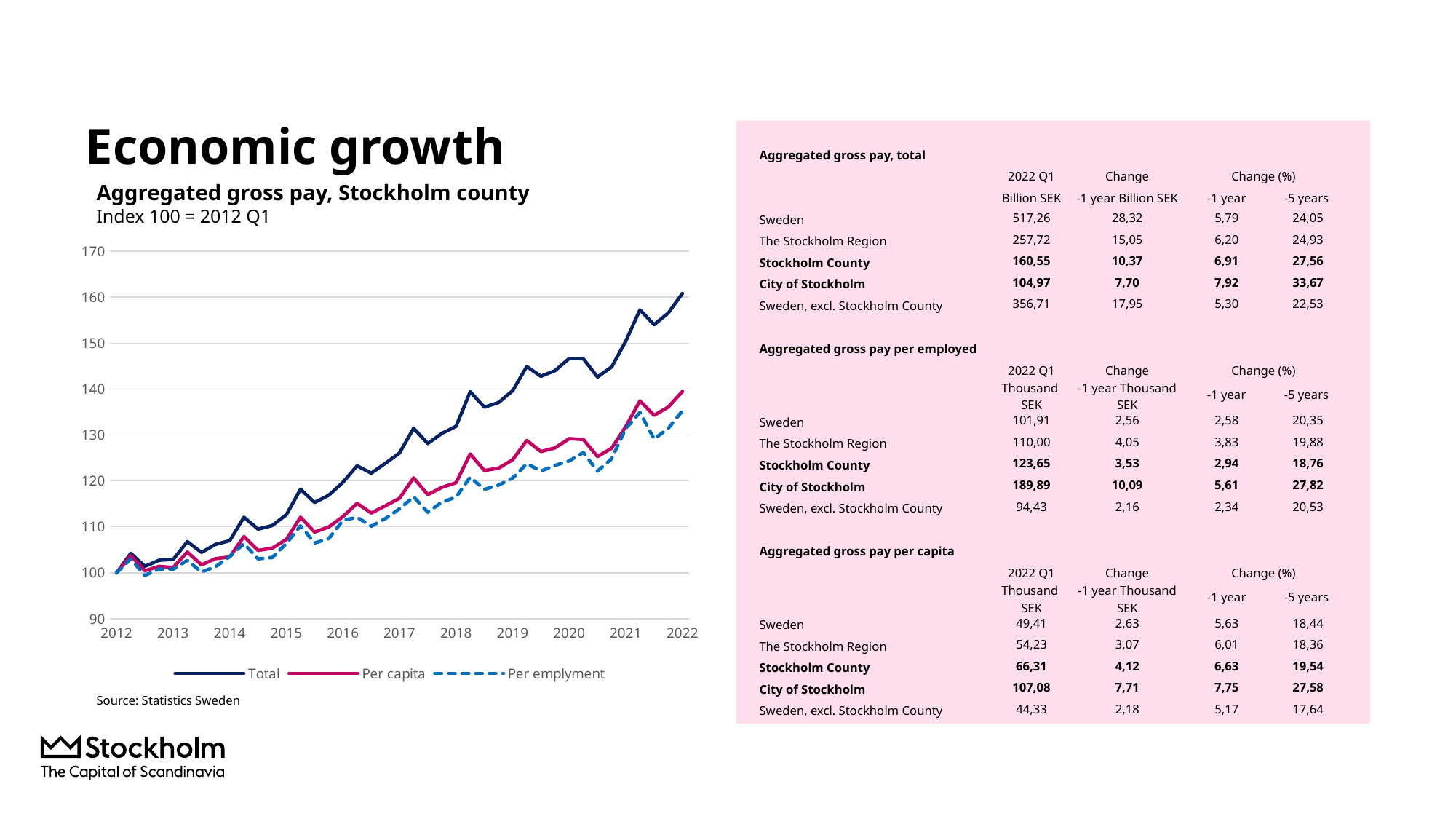
What is the index value of all three series at the start of 2012? 100 Do the values of the Total series rise or fall from 2012 to 2022? Rise What is the title of the chart? Aggregated gross pay, Stockholm county What kind of chart is shown on the slide? Line chart Is the value of the Per emplyment series at 2022 greater or less than 140? less How many series does the chart legend list? 3 Is the value of the Per capita series at 2022 greater or less than 130? greater Which series has the highest value at 2022? Total Which series has the lowest value at 2022? Per emplyment What are the series names listed in the chart legend? Total, Per capita, Per emplyment Is the value of the Total series at 2022 greater or less than 150? greater